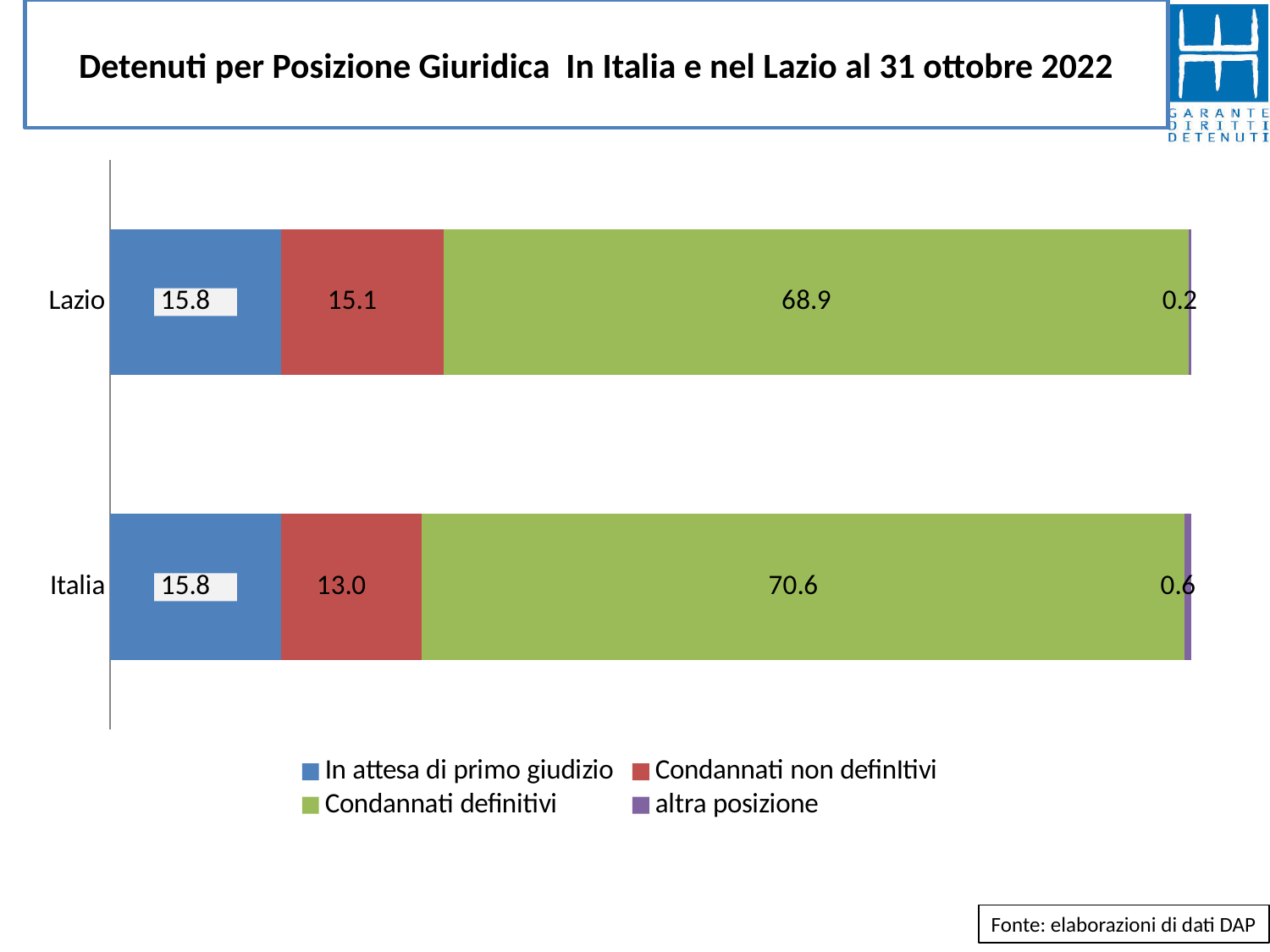
How many categories (bars) are shown in the chart? 2 What is the value for altra posizione in Italia? 0.6 Which series has the largest value in the Italia bar? Condannati definitivi What is the value for In attesa di primo giudizio in Lazio? 15.8 What is the difference between the Condannati definitivi values for Italia and Lazio? 1.7 What kind of chart is shown on the slide? Stacked bar chart Which is larger, the Condannati non definitivi value for Lazio or for Italia? Lazio What is the value for Condannati definitivi in Lazio? 68.9 What is the total of the stacked bar for Lazio? 100.0 Which series has the smallest value in the Lazio bar? altra posizione How many series does the legend list? 4 What is the value for Condannati non definitivi in Italia? 13.0